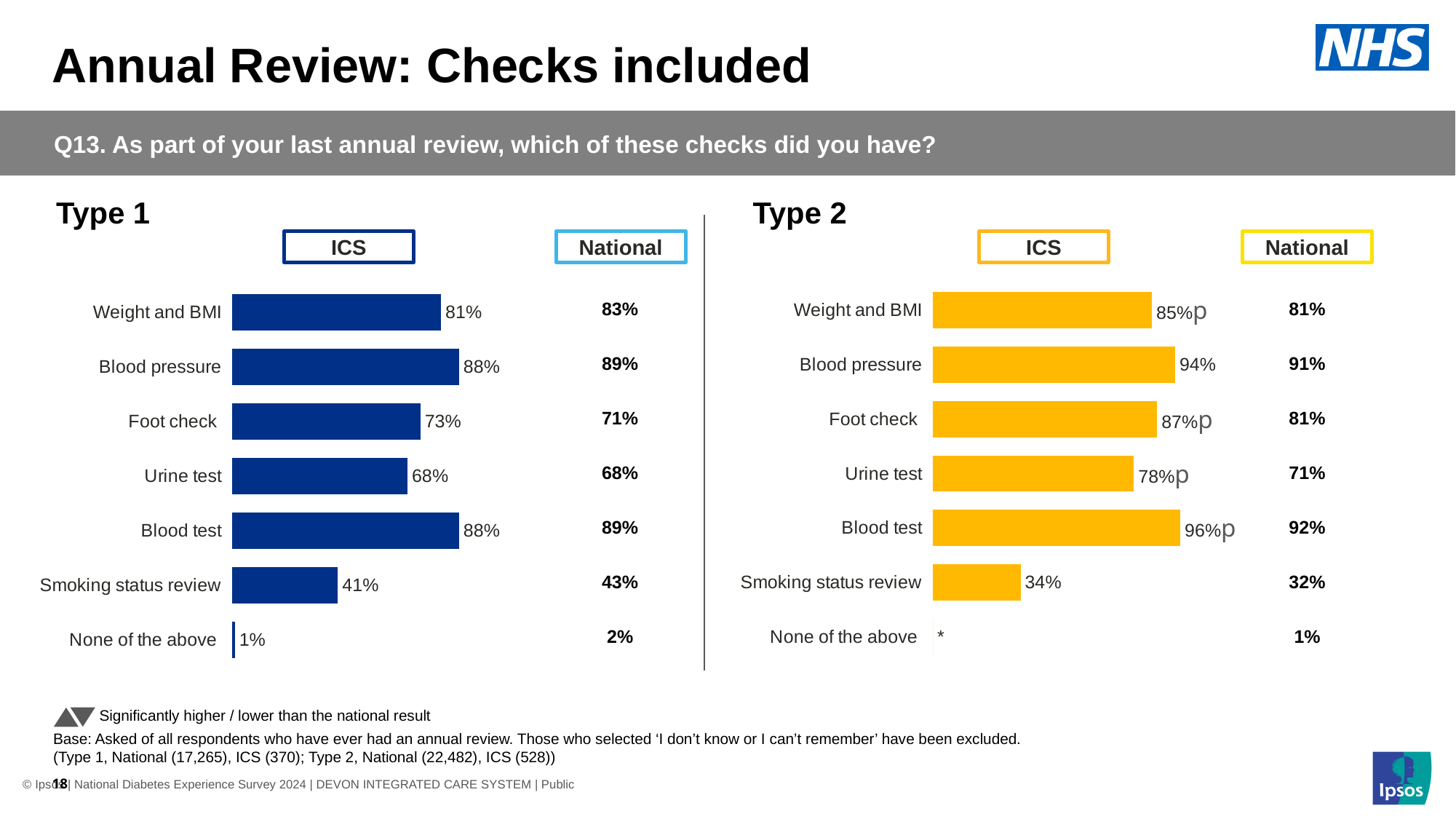
In the Type 2 chart, what is the difference between the ICS and National values for Urine test? 7 percentage points In the Type 2 chart, is the ICS value for Foot check higher or lower than the National value? higher What type of chart is used for the Type 2 ICS results? bar chart In the Type 1 chart, what is the ICS value for Foot check? 73% In the Type 2 chart, what is the ICS value for Blood pressure? 94% In the Type 1 chart, what is the National value for Smoking status review? 43% In the Type 2 chart, what is the ICS value for Smoking status review? 34% In the Type 1 chart, which check has the lowest ICS value? None of the above How many checks are listed in the Type 1 chart? 7 In the Type 2 chart, which check has the highest ICS value? Blood test What colour are the ICS bars in the Type 2 chart? yellow In the Type 1 chart, is the ICS value for Weight and BMI higher or lower than the National value? lower